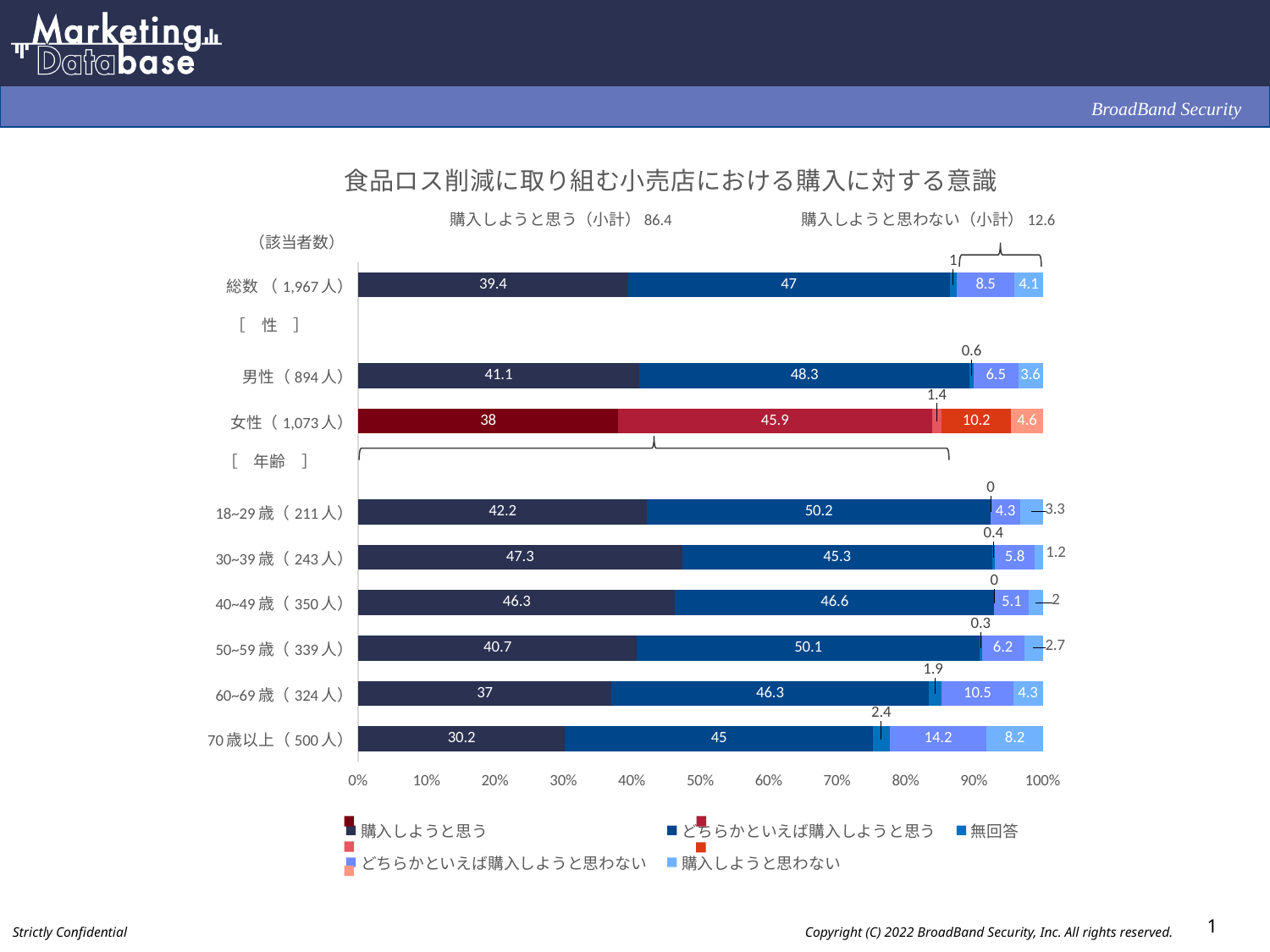
How many categories (bars) are plotted in the chart? 9 What is the value of どちらかといえば購入しようと思う for 女性 (1,073人)? 45.9 How many series does the legend list? 5 What is the value of 購入しようと思う for 総数 (1,967人)? 39.4 Which is larger, the どちらかといえば購入しようと思わない value for 60~69歳 (324人) or for 50~59歳 (339人)? 60~69歳 (324人) Which category has the lowest value for 購入しようと思う? 70歳以上 (500人) What is the 購入しようと思う (小計) value shown above the chart? 86.4 What is the difference between the 購入しようと思う values for 男性 (894人) and 女性 (1,073人)? 3.1 What is the title of the chart? 食品ロス削減に取り組む小売店における購入に対する意識 Which category has the highest value for 購入しようと思う? 30~39歳 (243人) What is the value of 購入しようと思わない for 70歳以上 (500人)? 8.2 What kind of chart is shown on the slide? Stacked bar chart